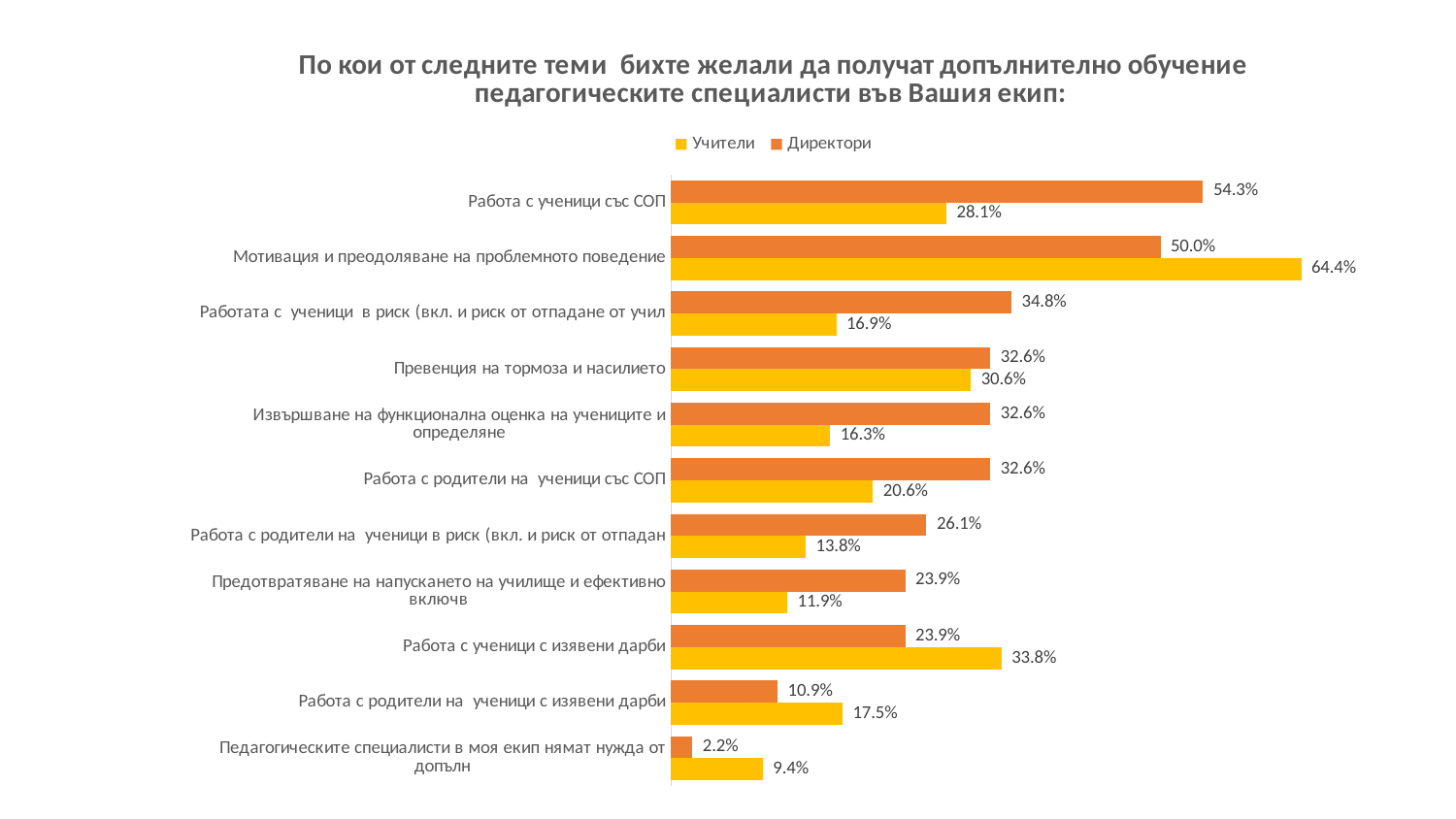
What is the value for Директори for "Педагогическите специалисти в моя екип нямат нужда от допълн"? 2.2% Which category has the highest value for Директори? Работа с ученици със СОП What is the value for Учители for "Работа с ученици с изявени дарби"? 33.8% What is the value for Директори for "Работа с ученици със СОП"? 54.3% For "Работа с родители на ученици с изявени дарби", which series has the larger value, Учители or Директори? Учители What type of chart is shown on the slide? bar chart Which colour represents the Учители series in the chart? yellow How many series does the legend list? 2 Which category has the lowest value for Учители? Педагогическите специалисти в моя екип нямат нужда от допълн How many categories are shown on the chart? 11 What is the value for Учители for "Мотивация и преодоляване на проблемното поведение"? 64.4% What is the difference between the Директори and Учители values for "Работата с ученици в риск (вкл. и риск от отпадане от учил"? 17.9%